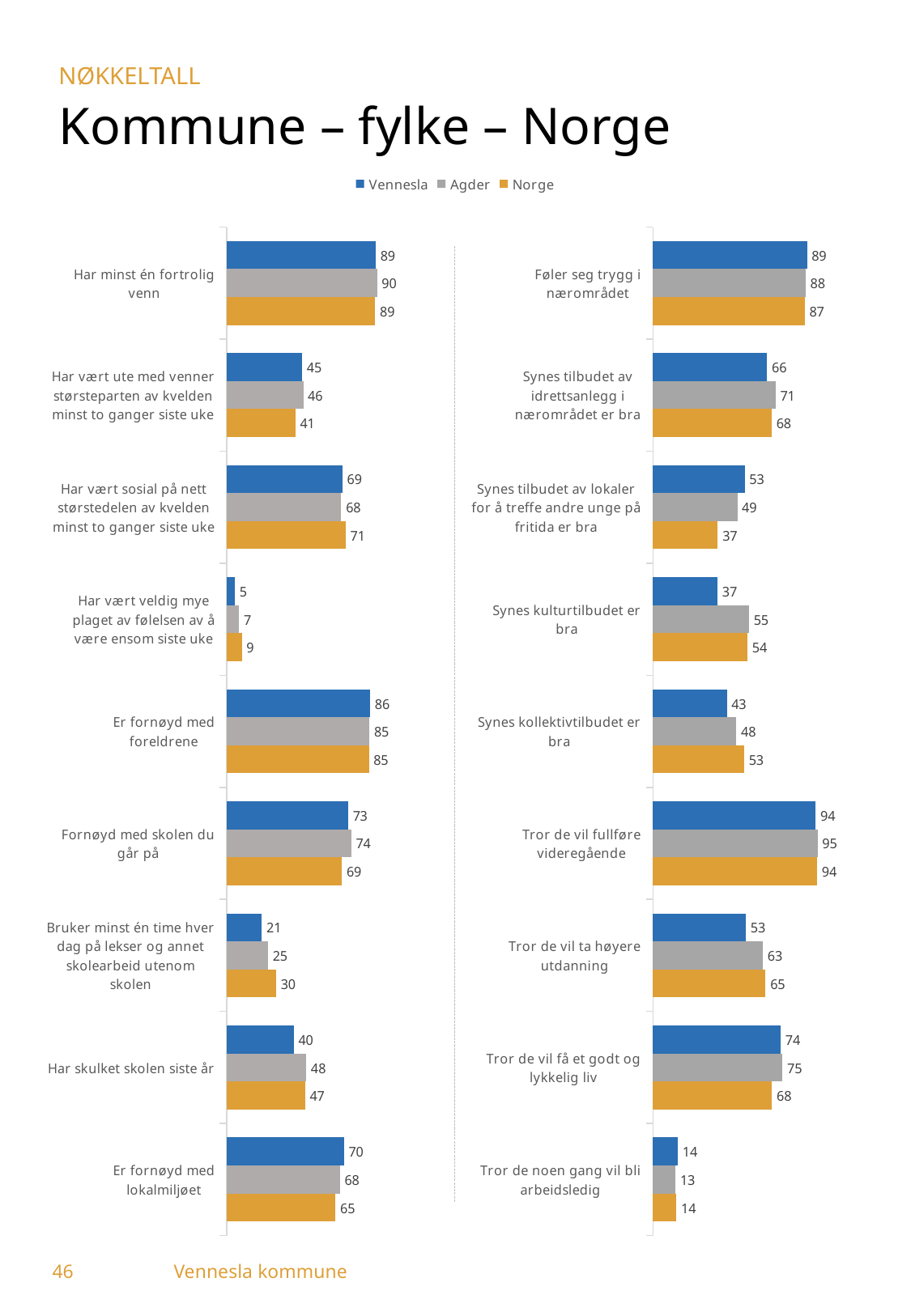
In the left chart, which is larger for 'Bruker minst én time hver dag på lekser og annet skolearbeid utenom skolen': Vennesla or Norge? Norge In the left chart, what is the Agder value for 'Har skulket skolen siste år'? 48 What kind of chart is used on this slide? Bar chart In the left chart, what is the Vennesla value for 'Har minst én fortrolig venn'? 89 In the right chart, which is larger for 'Tror de vil ta høyere utdanning': Vennesla or Agder? Agder Which series is shown in orange in the legend? Norge In the right chart, what is the difference between the Agder and Vennesla values for 'Synes kulturtilbudet er bra'? 18 In the left chart, which category has the lowest Norge value? Har vært veldig mye plaget av følelsen av å være ensom siste uke In the right chart, what is the Norge value for 'Synes tilbudet av lokaler for å treffe andre unge på fritida er bra'? 37 In the right chart, which category has the highest Vennesla value? Tror de vil fullføre videregående How many series does the legend list? 3 How many categories does the left chart show? 9